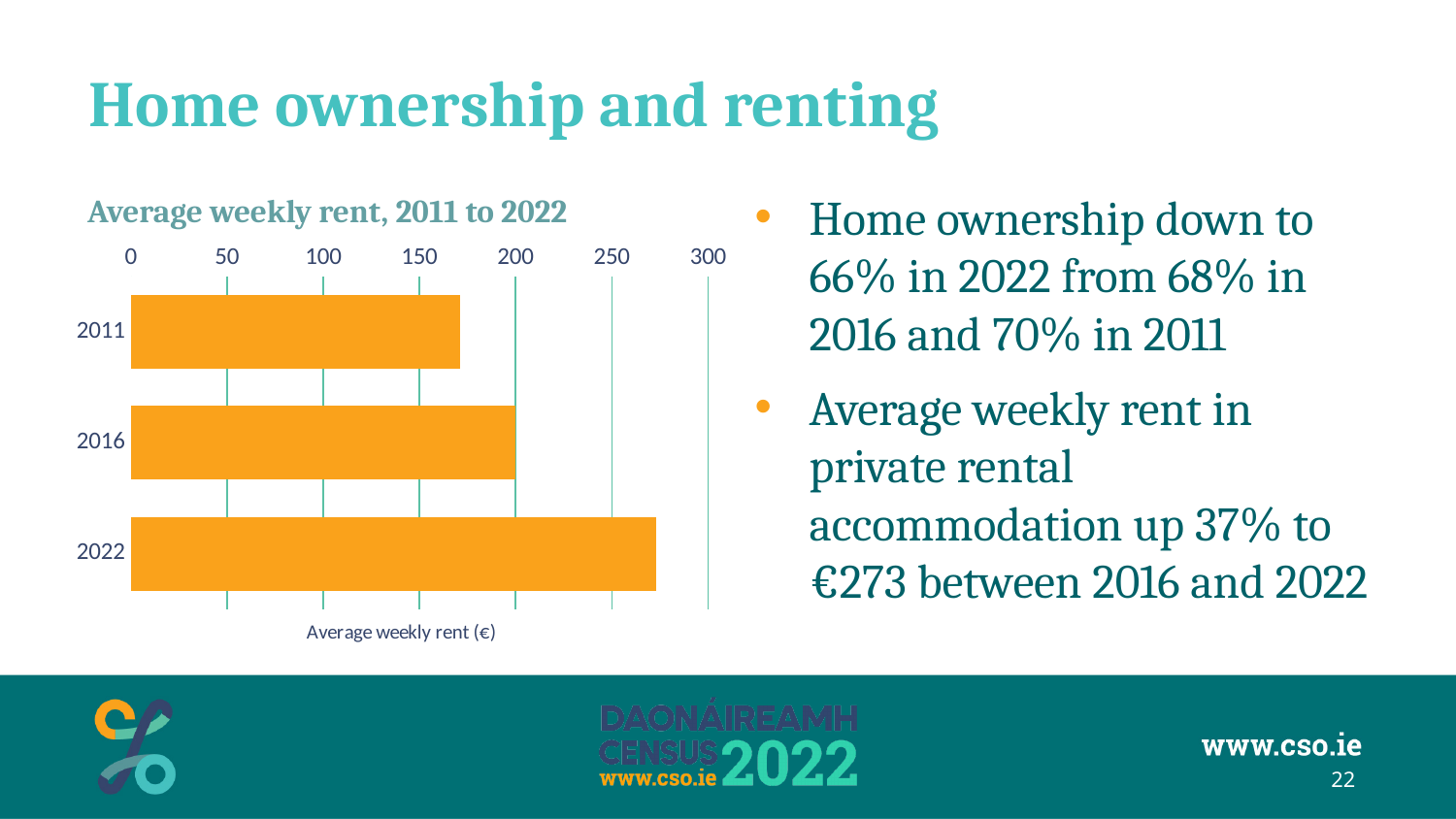
Which year has the highest average weekly rent in the chart? 2022 Is the average weekly rent for 2016 greater or less than 150? greater Is the average weekly rent for 2011 greater or less than 200? less Which year has the lowest average weekly rent in the chart? 2011 Does the average weekly rent rise or fall from 2011 to 2022 in the chart? rise Is the average weekly rent for 2011 greater or less than 150? greater What is the axis label shown beneath the bars? Average weekly rent (€) How many years are shown as categories in the chart? 3 What kind of chart is shown on the slide? bar chart Which is larger, the average weekly rent in 2016 or in 2022? 2022 What is the title of the chart? Average weekly rent, 2011 to 2022